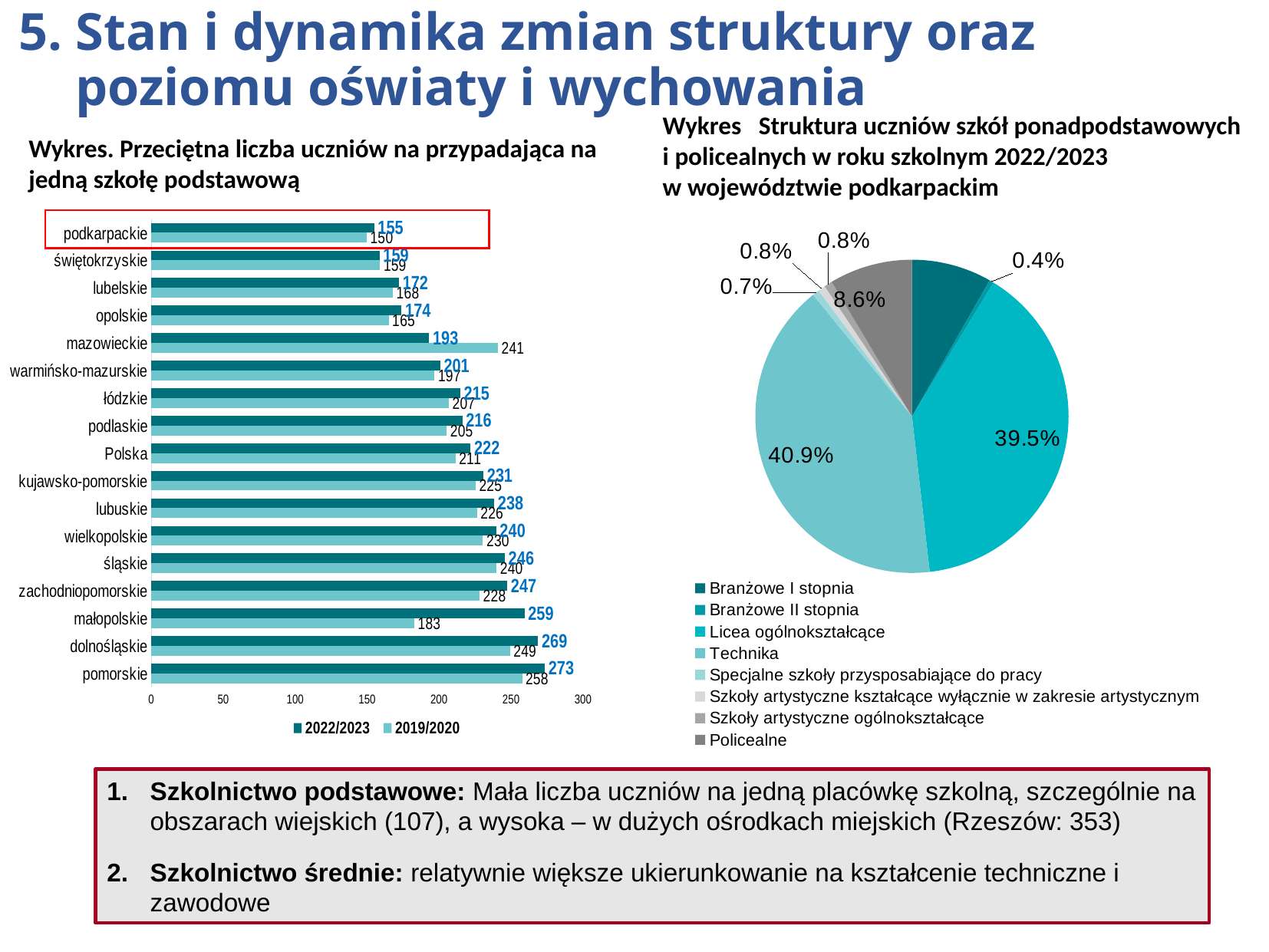
How many series does the legend of the left bar chart list? 2 In the left bar chart, which category has the highest value for 2022/2023? pomorskie How many categories are shown in the left bar chart? 17 In the left bar chart, what is the difference between the 2022/2023 and 2019/2020 values for małopolskie? 76 In the pie chart 'Struktura uczniów szkół ponadpodstawowych i policealnych', what share does Technika have? 40.9% What type of chart is the left chart, 'Przeciętna liczba uczniów na przypadająca na jedną szkołę podstawową'? bar chart In the left bar chart, which category has the lowest value for 2022/2023? podkarpackie In the pie chart 'Struktura uczniów szkół ponadpodstawowych i policealnych', what share does Licea ogólnokształcące have? 39.5% In the left bar chart, for mazowieckie, which series has the larger value: 2022/2023 or 2019/2020? 2019/2020 In the left bar chart, what is the value for podkarpackie in 2022/2023? 155 In the left bar chart, what is the value for mazowieckie in 2019/2020? 241 In the left bar chart, what is the value for Polska in 2022/2023? 222